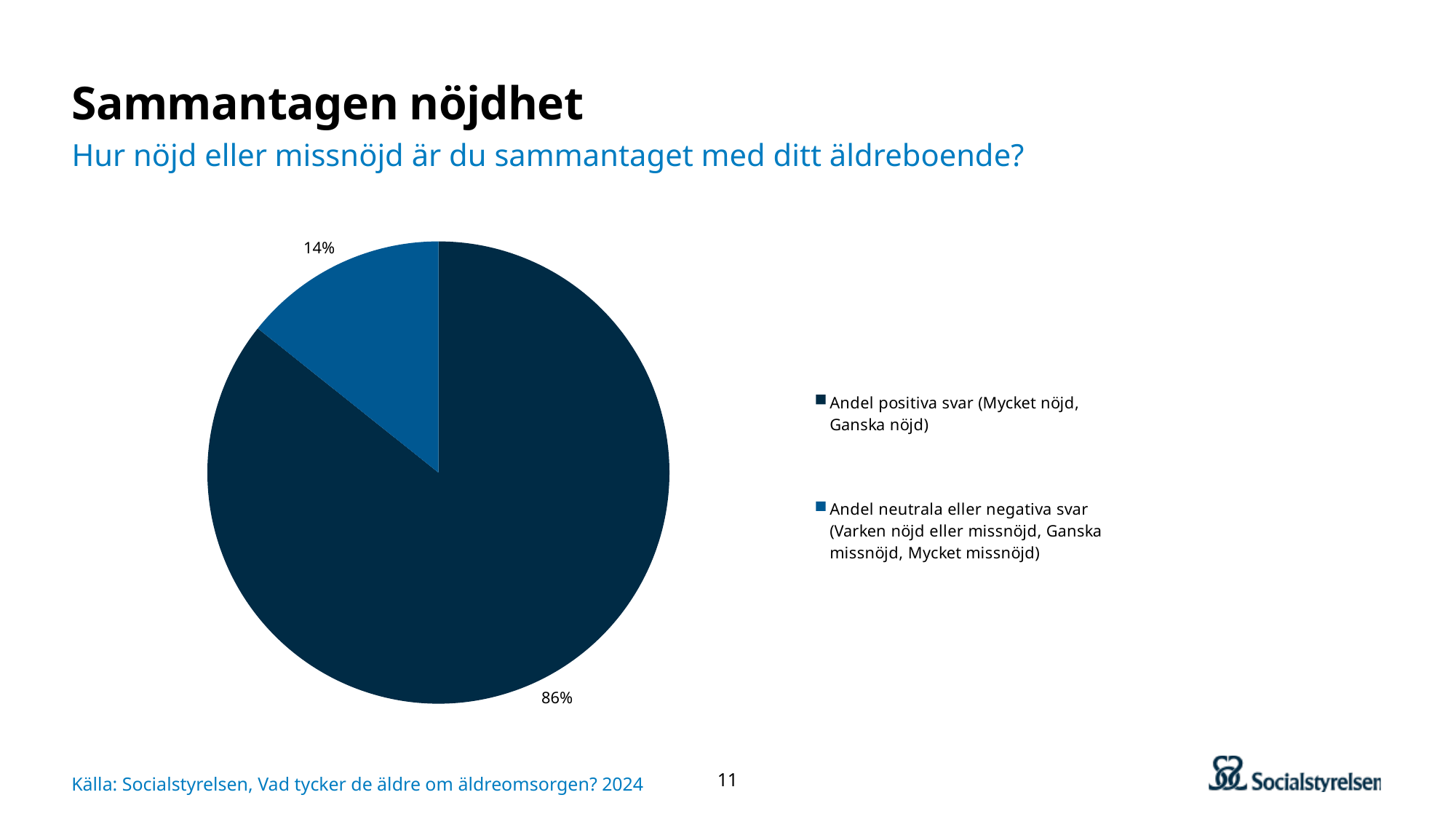
How many slices does the pie chart have? 2 What is the difference in percentage points between the positive slice and the neutral/negative slice? 72 percentage points Which slice of the pie is the smallest? Andel neutrala eller negativa svar (Varken nöjd eller missnöjd, Ganska missnöjd, Mycket missnöjd) How many entries does the legend list? 2 What share of the pie is labelled for 'Andel neutrala eller negativa svar'? 14% What is the source cited at the bottom of the slide? Socialstyrelsen, Vad tycker de äldre om äldreomsorgen? 2024 What question is shown as the subtitle above the chart? Hur nöjd eller missnöjd är du sammantaget med ditt äldreboende? Which is larger: the share of positive answers or the share of neutral or negative answers? positive answers What share of the pie is labelled for 'Andel positiva svar (Mycket nöjd, Ganska nöjd)'? 86% Which slice of the pie is the largest? Andel positiva svar (Mycket nöjd, Ganska nöjd) What is the total of the two slice labels shown on the pie? 100% What kind of chart is shown on the slide? pie chart